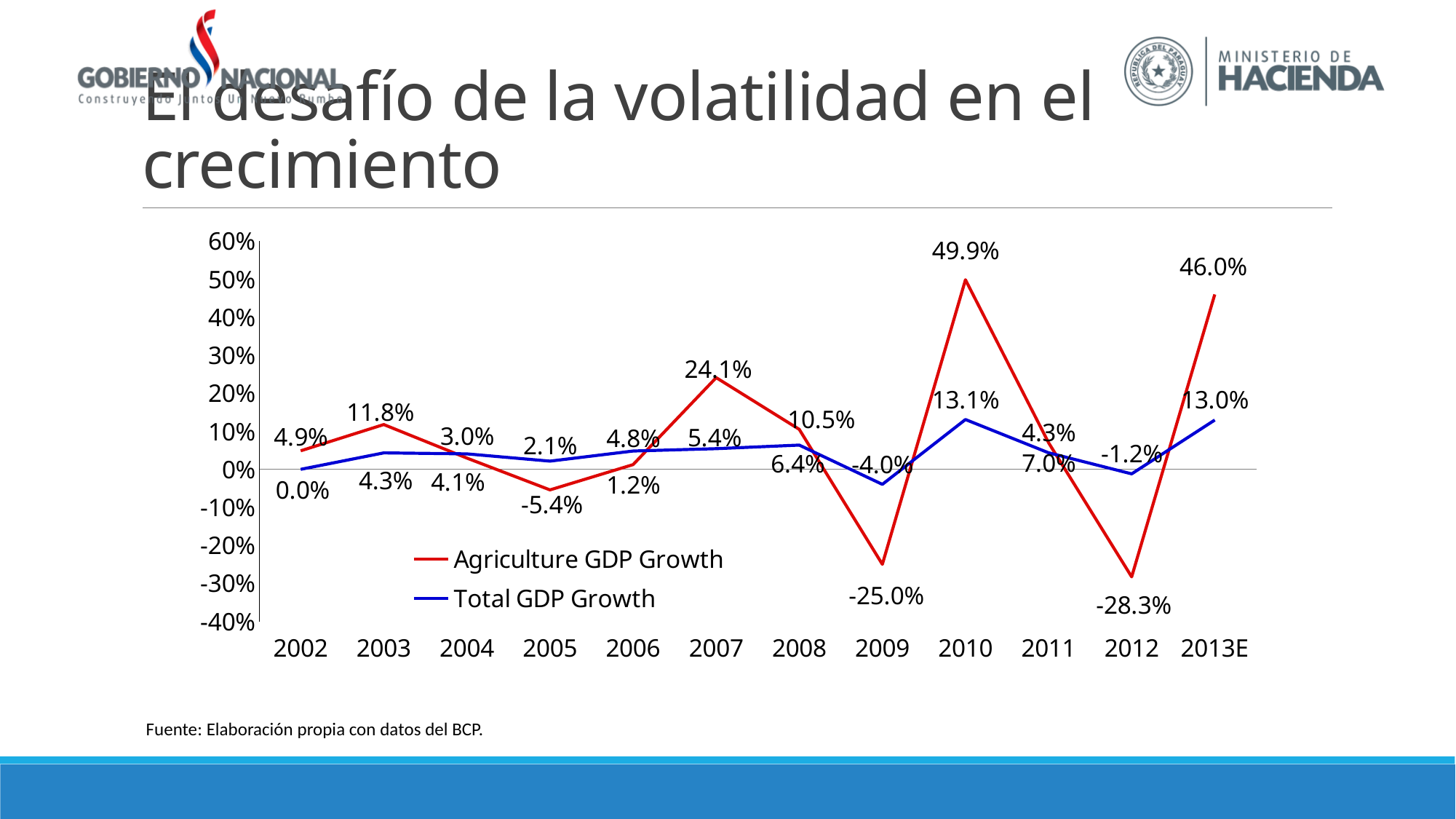
What colour is the line for Total GDP Growth? Blue How many series does the legend list? 2 Which is larger in 2004: Agriculture GDP Growth or Total GDP Growth? Total GDP Growth How many years are shown on the x axis? 12 What kind of chart is shown on the slide? Line chart In which year is Total GDP Growth highest? 2010 What is the Agriculture GDP Growth value for 2010? 49.9% What is the difference between Agriculture GDP Growth and Total GDP Growth in 2007? 18.7% What is the Total GDP Growth value for 2009? -4.0% In which year is Agriculture GDP Growth lowest? 2012 What is the Agriculture GDP Growth value for 2013E? 46.0% Does Agriculture GDP Growth rise or fall from 2011 to 2012? Fall